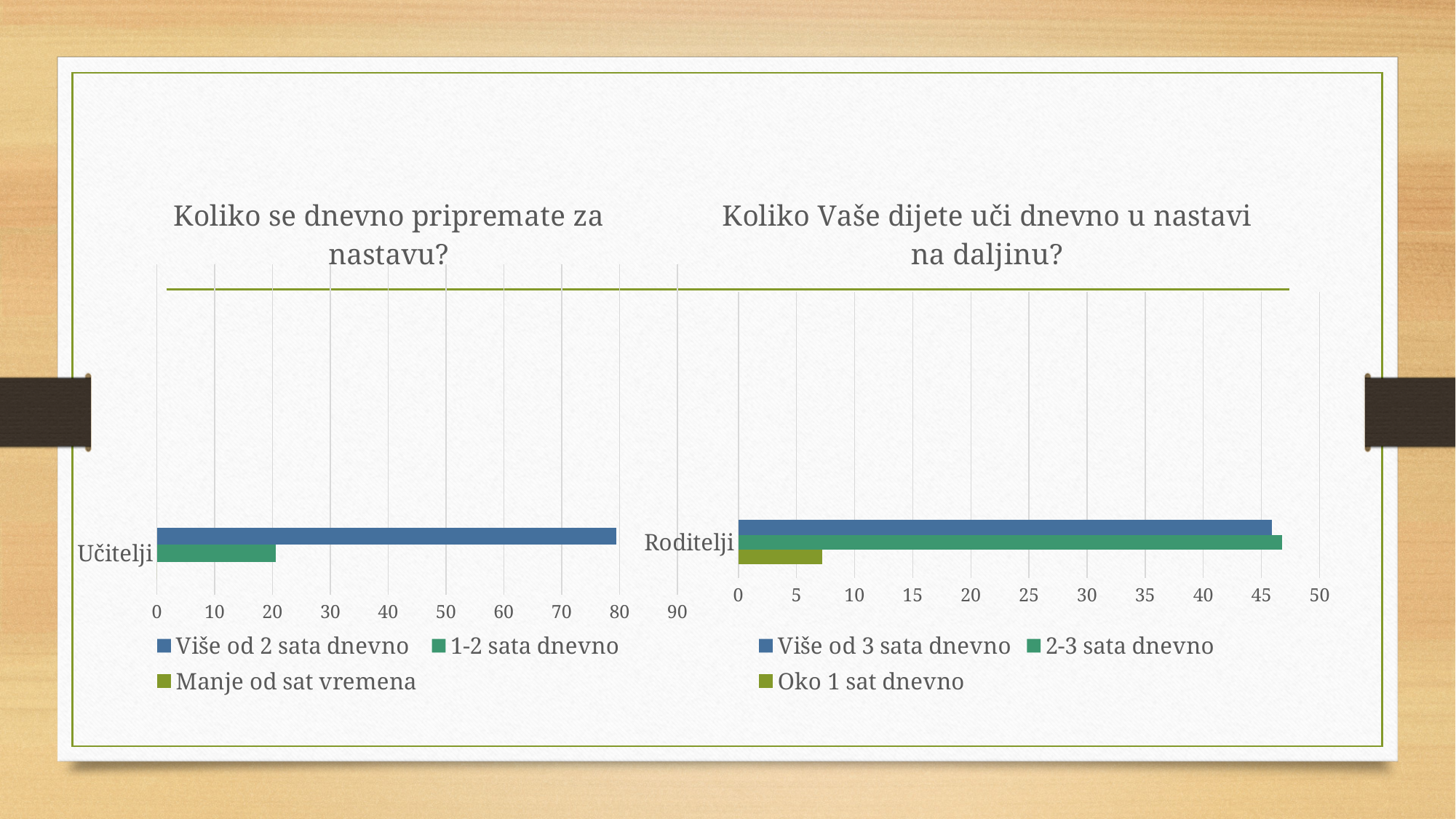
In the left chart "Koliko se dnevno pripremate za nastavu?", which series has the highest value for Učitelji? Više od 2 sata dnevno In the right chart "Koliko Vaše dijete uči dnevno u nastavi na daljinu?", which series has the lowest value for Roditelji? Oko 1 sat dnevno How many series does the legend of the left chart "Koliko se dnevno pripremate za nastavu?" list? 3 In the left chart "Koliko se dnevno pripremate za nastavu?", is the value for "Više od 2 sata dnevno" greater or less than 70? greater In the right chart "Koliko Vaše dijete uči dnevno u nastavi na daljinu?", is the value for "Oko 1 sat dnevno" greater or less than 10? less In the left chart "Koliko se dnevno pripremate za nastavu?", is the value for "1-2 sata dnevno" greater or less than 30? less How many series does the legend of the right chart "Koliko Vaše dijete uči dnevno u nastavi na daljinu?" list? 3 What kind of chart is the left chart titled "Koliko se dnevno pripremate za nastavu?"? bar chart In the right chart "Koliko Vaše dijete uči dnevno u nastavi na daljinu?", which is larger for Roditelji: "2-3 sata dnevno" or "Oko 1 sat dnevno"? 2-3 sata dnevno In the left chart "Koliko se dnevno pripremate za nastavu?", which is larger for Učitelji: "Više od 2 sata dnevno" or "1-2 sata dnevno"? Više od 2 sata dnevno What is the category label shown on the right chart "Koliko Vaše dijete uči dnevno u nastavi na daljinu?"? Roditelji